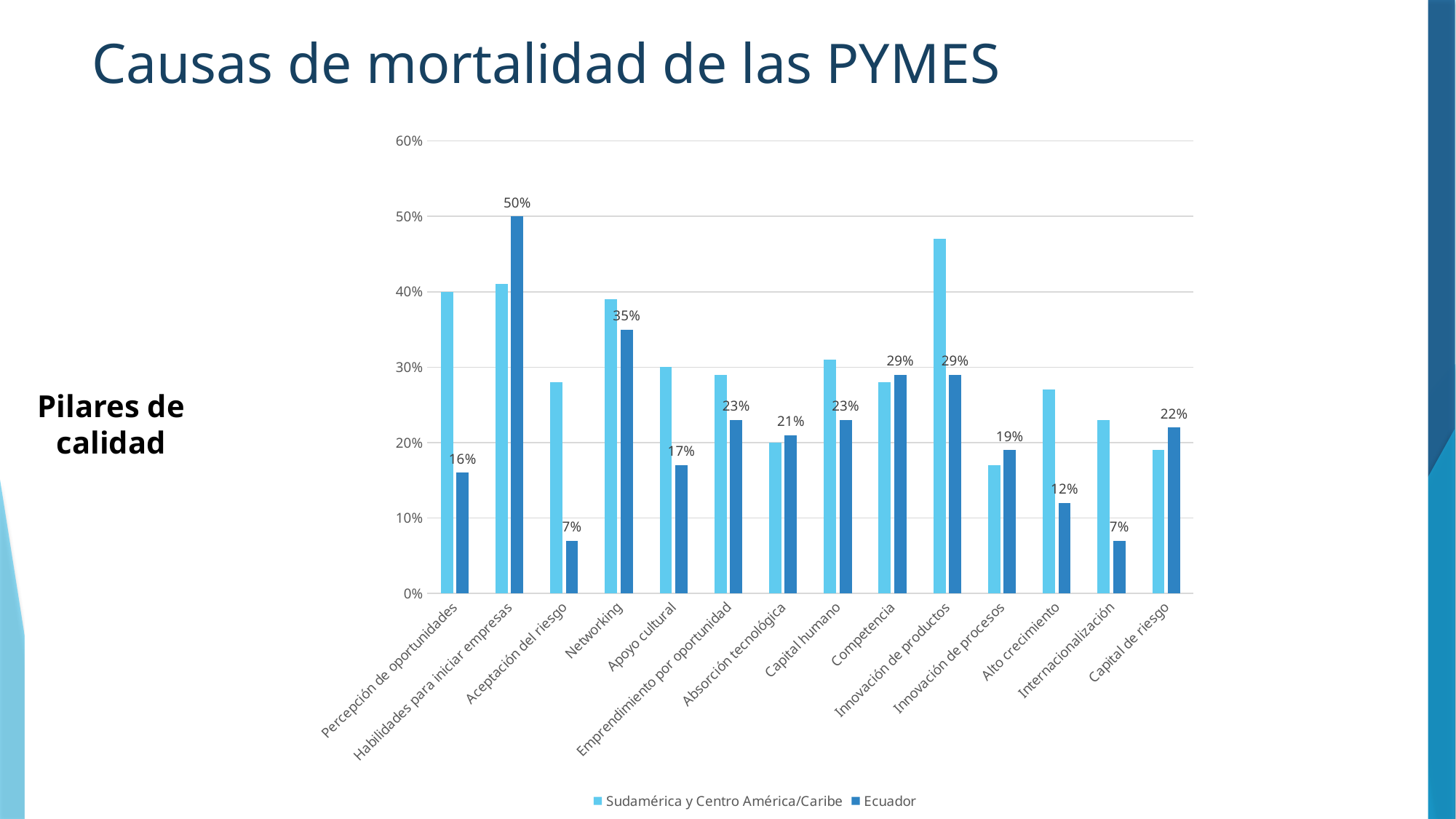
For Percepción de oportunidades, which series has the larger value? Sudamérica y Centro América/Caribe What is the Ecuador value for Habilidades para iniciar empresas? 50% What is the difference between the Ecuador values for Networking and Alto crecimiento? 23 percentage points What is the Ecuador value for Networking? 35% How many categories are shown on the x axis? 14 Which category has the highest Ecuador value? Habilidades para iniciar empresas How many series does the legend list? 2 Is the Sudamérica y Centro América/Caribe value for Innovación de procesos greater or less than 20%? less Is the Sudamérica y Centro América/Caribe value for Innovación de productos greater or less than 40%? greater Which has a larger Ecuador value, Competencia or Capital de riesgo? Competencia What kind of chart is shown on the slide? Bar chart What is the Ecuador value for Capital de riesgo? 22%